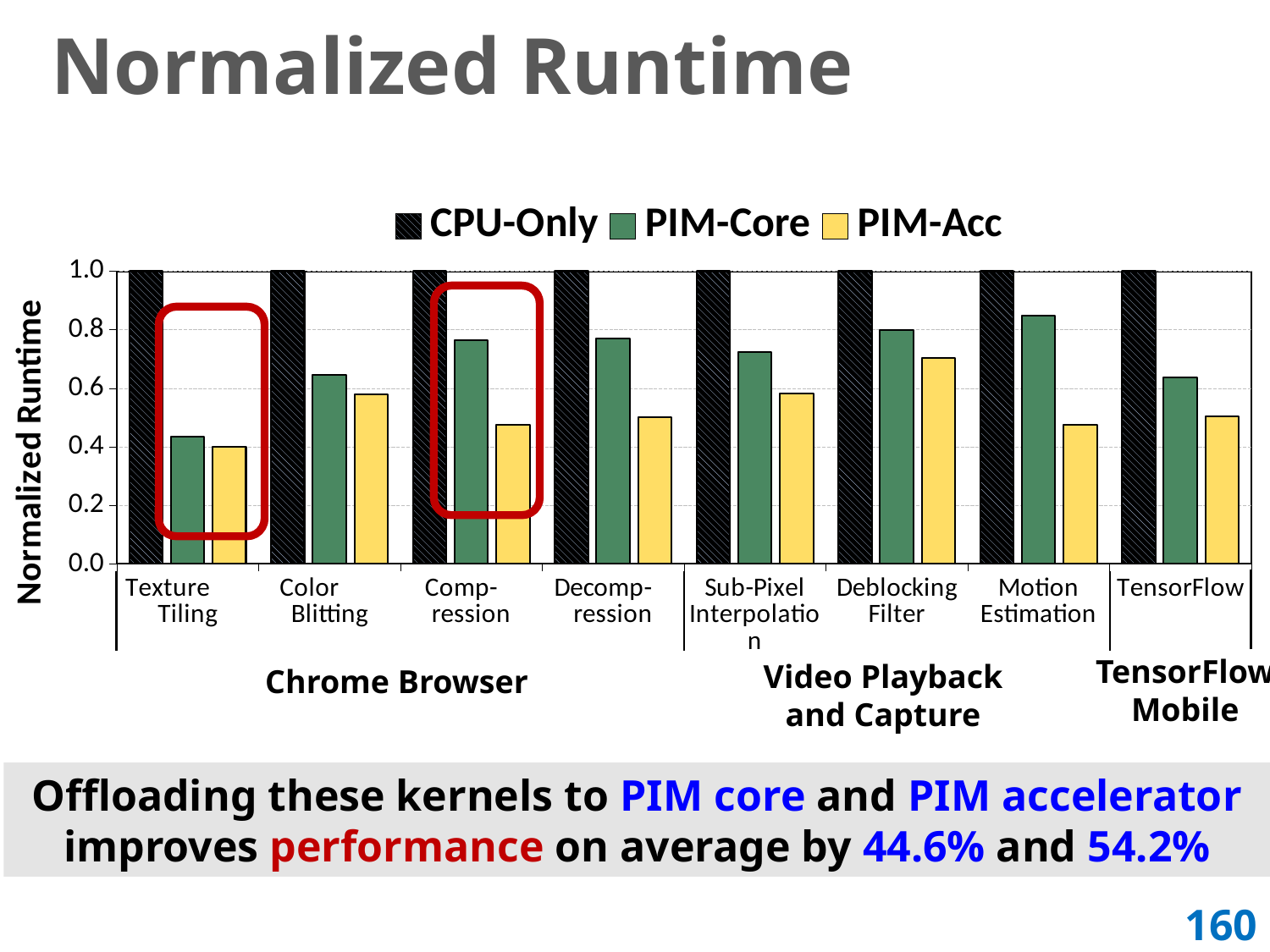
Which category has the highest PIM-Acc normalized runtime? Deblocking Filter Is the PIM-Core value for Motion Estimation greater or less than 0.6? greater Is the PIM-Core value for Texture Tiling greater or less than 0.6? less How many kernel categories are plotted along the x axis? 8 Which is larger: the PIM-Acc value for Deblocking Filter or the PIM-Acc value for Texture Tiling? Deblocking Filter Is the PIM-Acc value for Deblocking Filter greater or less than 0.6? greater What kind of chart is shown on the slide? bar chart What is the normalized runtime of CPU-Only for Texture Tiling? 1.0 Which category has the lowest PIM-Core normalized runtime? Texture Tiling What is the label on the y axis of the chart? Normalized Runtime How many series does the legend list? 3 For Compression, which is larger: the PIM-Core value or the PIM-Acc value? PIM-Core